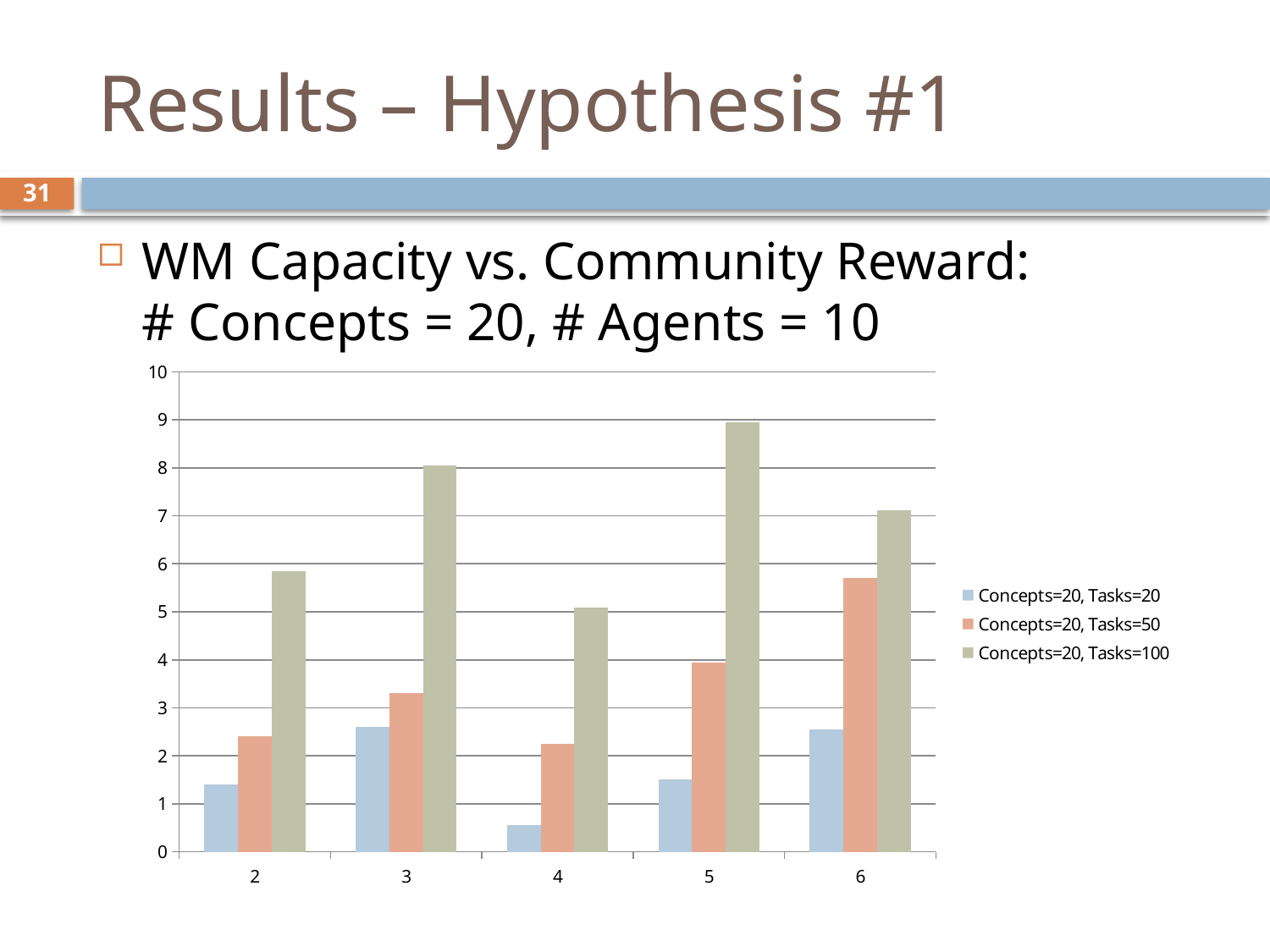
Which series is shown in the legend with the third (bottom) entry? Concepts=20, Tasks=100 How many series does the legend list? 3 For the Concepts=20, Tasks=100 series, which is larger: the value at category 3 or at category 6? category 3 For the Concepts=20, Tasks=50 series, which category has the highest value? 6 Is the value for Concepts=20, Tasks=50 at category 6 greater or less than 5? greater What kind of chart is shown on the slide? bar chart Is the value for Concepts=20, Tasks=20 at category 4 greater or less than 1? less For the Concepts=20, Tasks=20 series, which category has the lowest value? 4 How many categories are shown on the x axis? 5 For the Concepts=20, Tasks=100 series, which category has the highest value? 5 Is the value for Concepts=20, Tasks=100 at category 2 greater or less than 5? greater